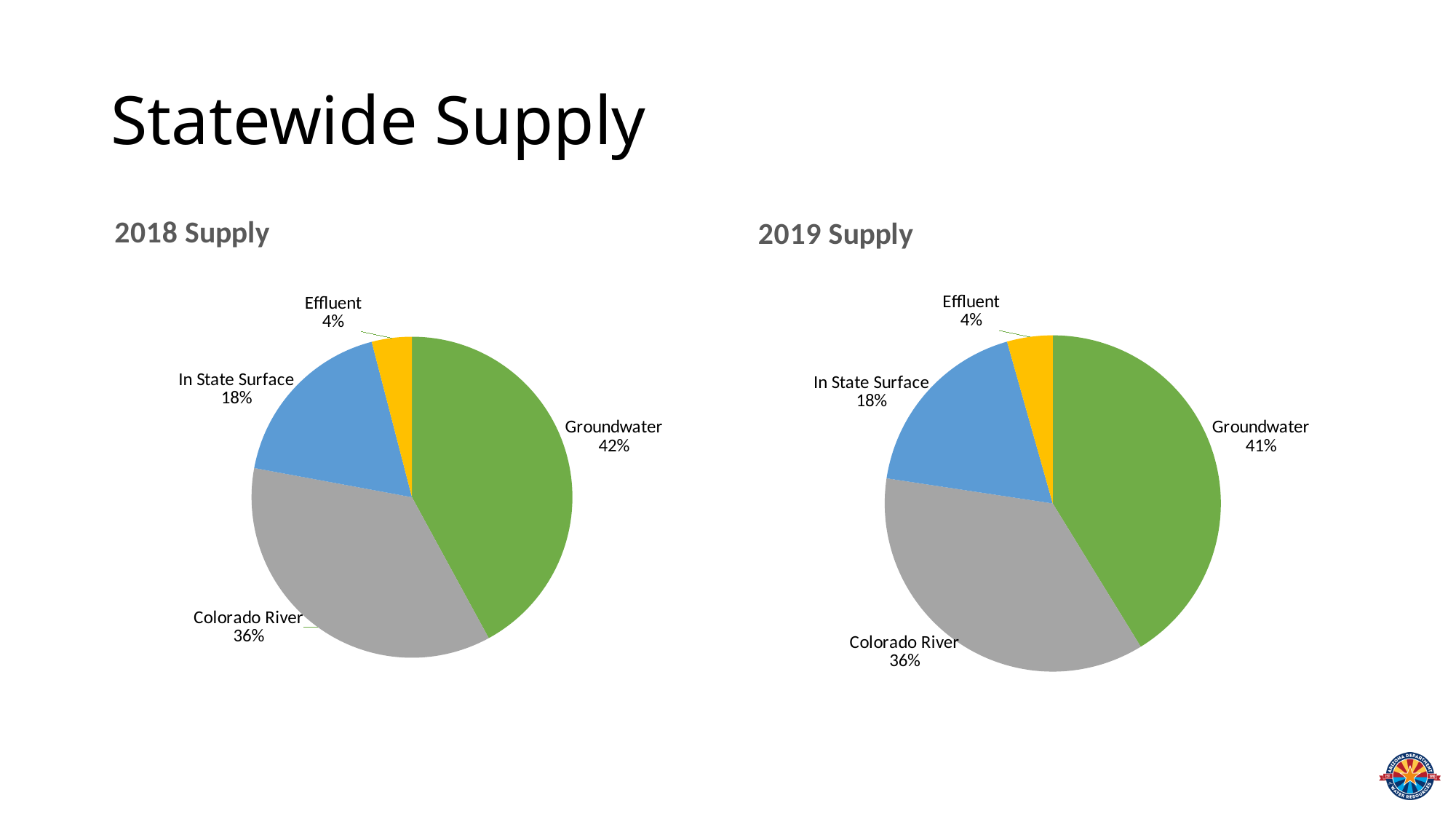
How many categories does the 2018 Supply chart show? 4 In the 2019 Supply chart, what is the difference between the In State Surface and Effluent shares? 14% In the 2018 Supply chart, what is the difference between the Groundwater and Colorado River shares? 6% In the 2019 Supply chart, what is the value for In State Surface? 18% In the 2018 Supply chart, which category has the largest share? Groundwater In the 2018 Supply chart, what share of supply is Groundwater? 42% In the 2019 Supply chart, what share of supply is Groundwater? 41% In the 2019 Supply chart, which is larger, Colorado River or In State Surface? Colorado River In the 2018 Supply chart, what colour is the Effluent slice? Yellow In the 2019 Supply chart, which category has the smallest share? Effluent What kind of chart is the 2019 Supply chart? Pie chart In the 2018 Supply chart, what is the value for Colorado River? 36%